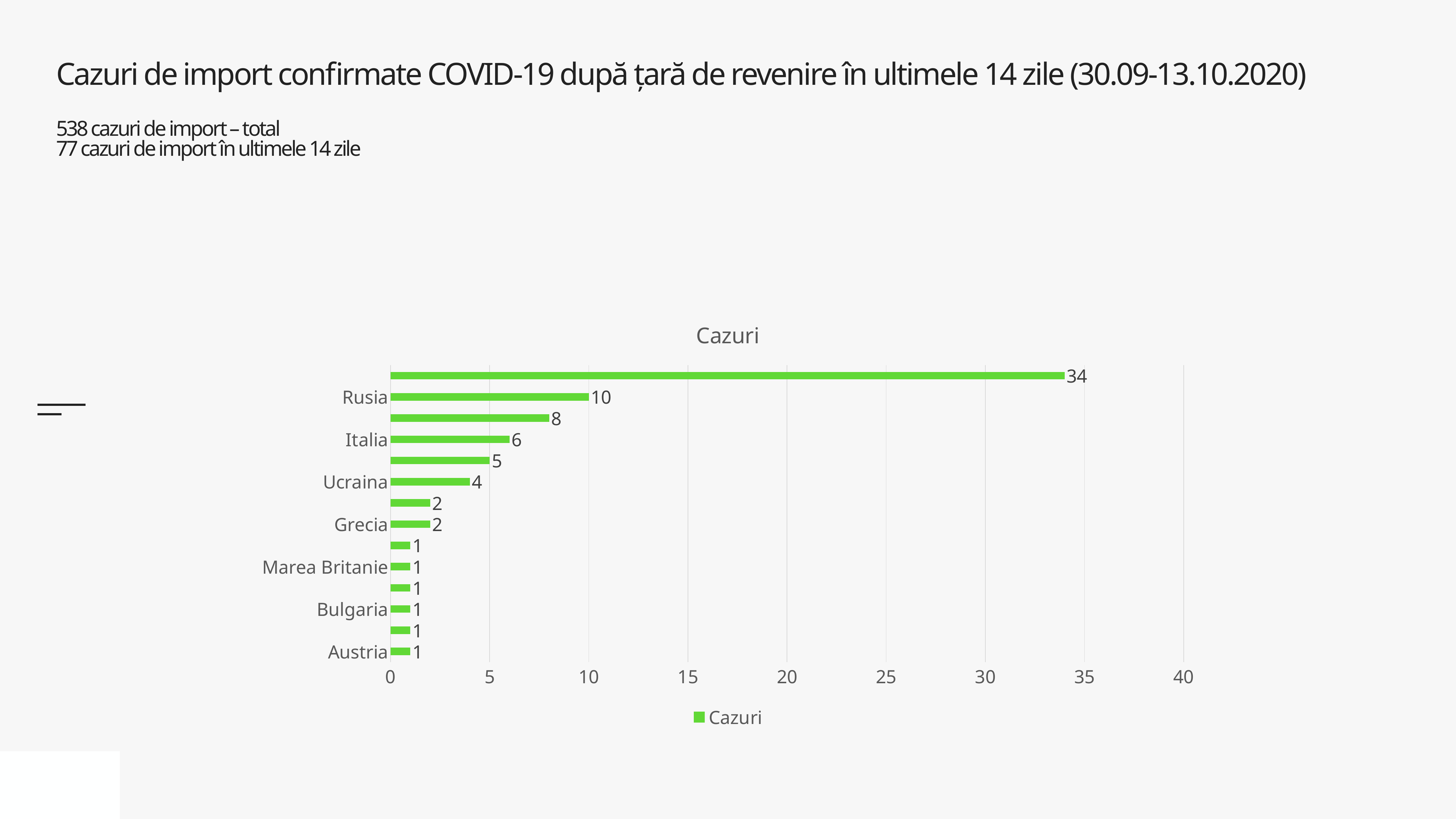
What is the value for Ucraina? 4 What is the value for Italia? 6 What is the largest value shown on the chart? 34 Is the value for Rusia greater or less than 5? greater What is the name of the series listed in the legend? Cazuri What is the value for Marea Britanie? 1 What kind of chart is shown on the slide? bar chart What is the difference between the values for Rusia and Italia? 4 How many bars are plotted on the chart? 14 Which is larger, the value for Rusia or the value for Ucraina? Rusia What is the value for Rusia? 10 What is the value for Grecia? 2